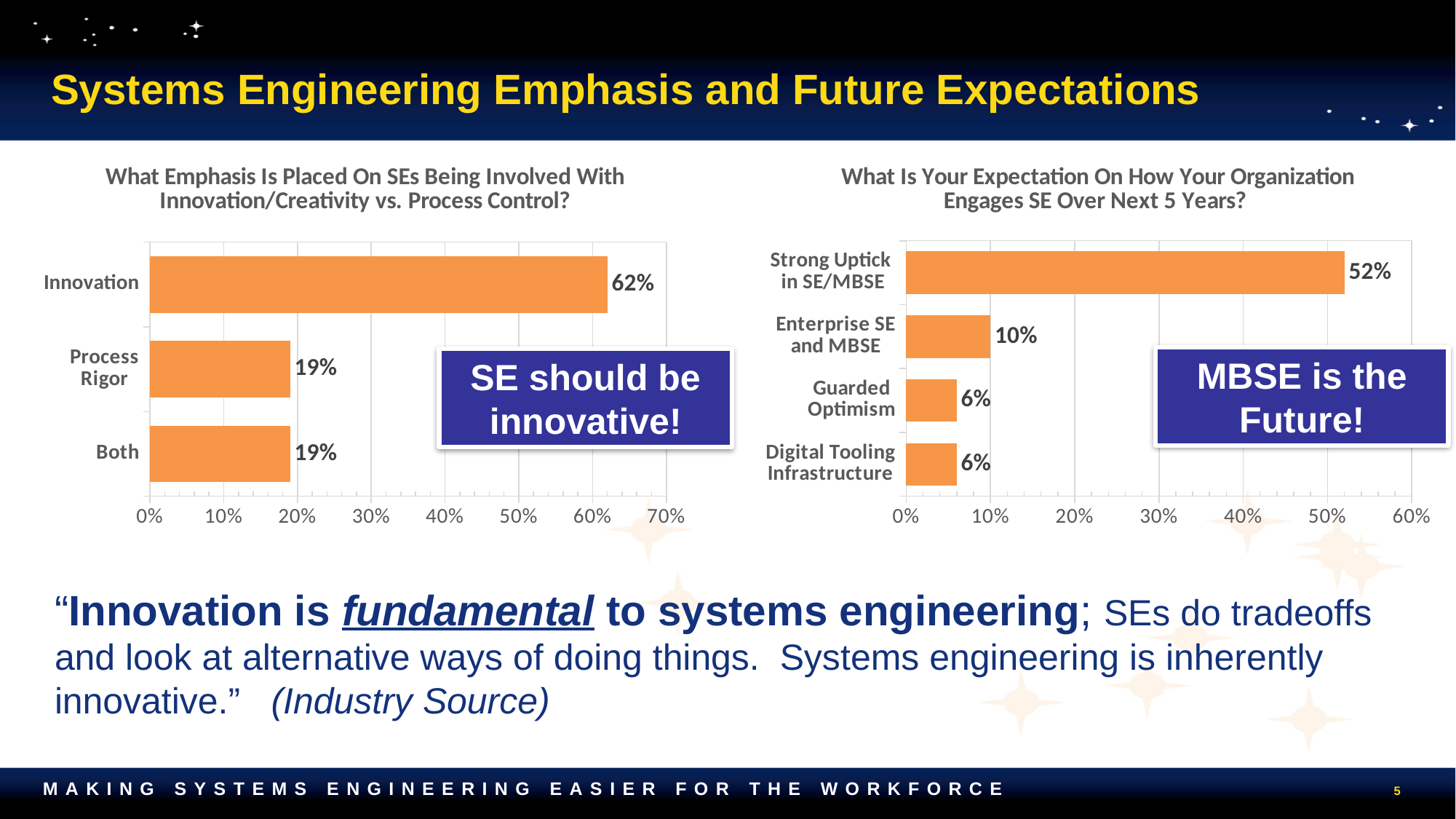
In the left chart, which category has the highest value? Innovation What kind of chart is the right chart? Bar chart In the right chart (What Is Your Expectation On How Your Organization Engages SE Over Next 5 Years?), what is the value for Strong Uptick in SE/MBSE? 52% In the right chart, how many categories are shown? 4 In the left chart, how many categories are shown? 3 In the right chart, what is the value for Guarded Optimism? 6% In the right chart, which category has the highest value? Strong Uptick in SE/MBSE In the left chart (What Emphasis Is Placed On SEs Being Involved With Innovation/Creativity vs. Process Control?), what is the value for Innovation? 62% In the left chart, what is the difference between the values for Innovation and Both? 43% In the right chart, what is the value for Enterprise SE and MBSE? 10% In the right chart, what is the difference between the values for Strong Uptick in SE/MBSE and Enterprise SE and MBSE? 42% In the left chart, what is the value for Process Rigor? 19%